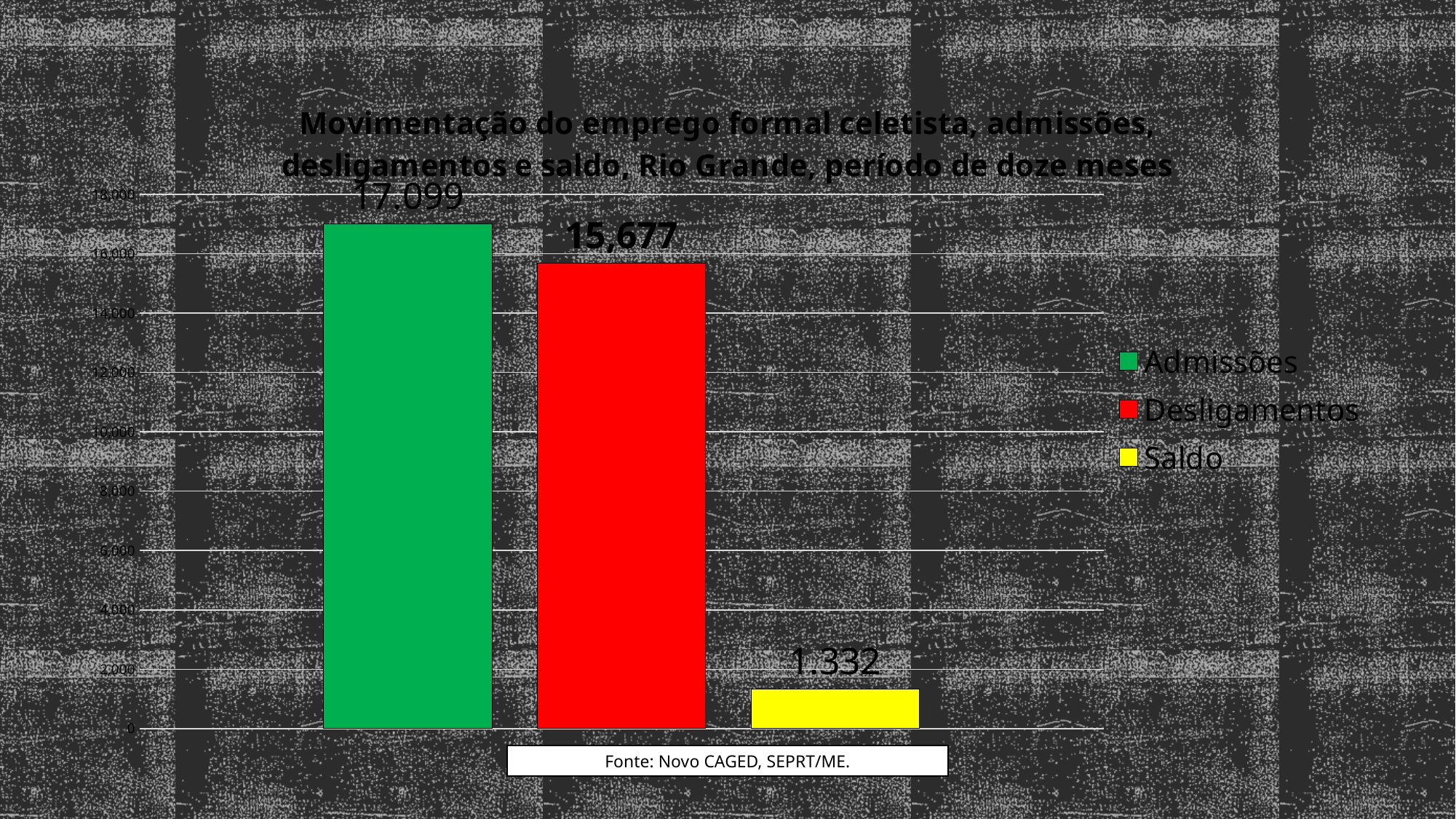
What is the value for Desligamentos? 15,677 Which series has the lowest value? Saldo Which is larger, Desligamentos or Saldo? Desligamentos What kind of chart is shown on the slide? bar chart Which series has the highest value? Admissões What colour is the bar for Saldo? yellow Is the value for Saldo greater or less than 2,000? less What is the value for Saldo? 1.332 How many series does the legend list? 3 What source is cited below the chart? Novo CAGED, SEPRT/ME. What is the value for Admissões? 17.099 What is the difference between Admissões and Desligamentos? 1.422